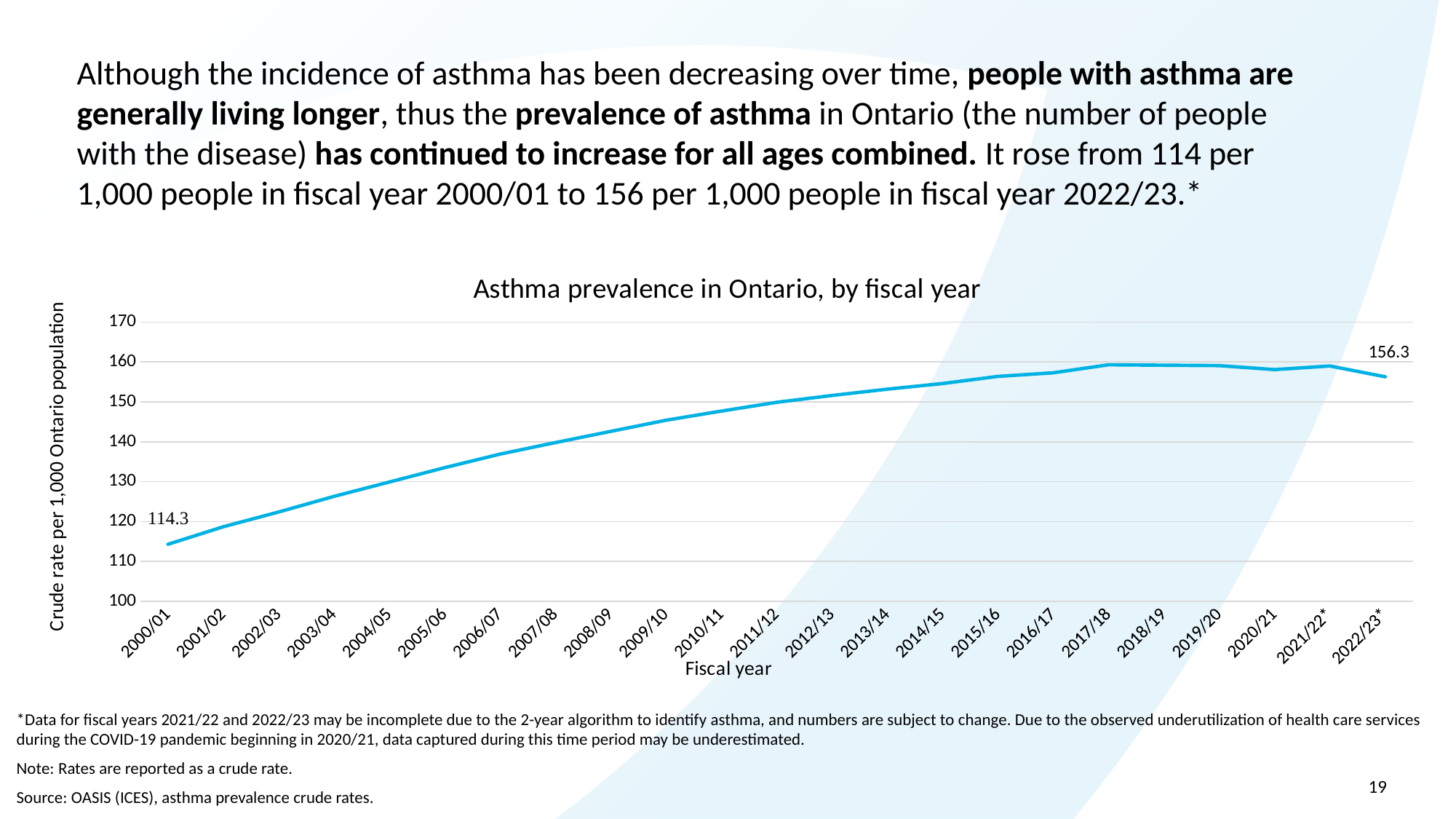
Is the value for 2003/04 greater or less than 130? less Which fiscal year has the lowest asthma prevalence rate? 2000/01 What is the asthma prevalence crude rate for fiscal year 2022/23? 156.3 What is the asthma prevalence crude rate for fiscal year 2000/01? 114.3 By how much did the crude rate increase from 2000/01 to 2022/23? 42.0 Is the value for 2012/13 greater or less than 140? greater Does the asthma prevalence rate generally rise or fall from 2000/01 to 2022/23? Rise Is the value for 2017/18 greater or less than 150? greater What is the title of the chart? Asthma prevalence in Ontario, by fiscal year How many fiscal years are plotted on the x axis? 23 What kind of chart is shown on the slide? Line chart Which fiscal year has the higher asthma prevalence rate, 2000/01 or 2022/23? 2022/23